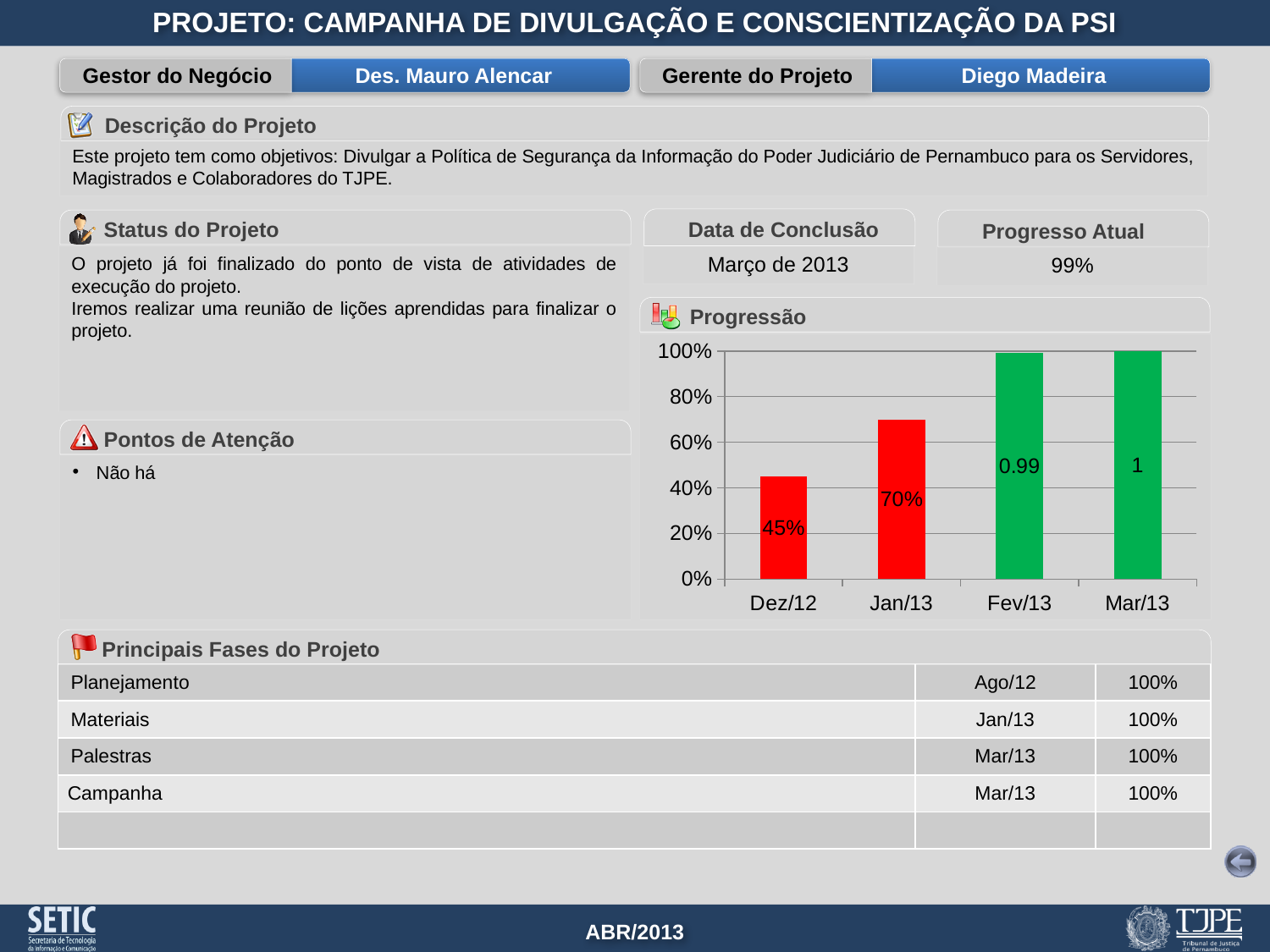
In the Progressão chart, is the value for Jan/13 greater or less than 60%? greater Do the values in the Progressão chart rise or fall from Dez/12 to Mar/13? rise In the Progressão chart, which is larger: the value for Dez/12 or the value for Jan/13? Jan/13 What kind of chart is the Progressão chart? bar chart What is the value for Jan/13 in the Progressão chart? 70% Which month has the lowest value in the Progressão chart? Dez/12 What data label is shown on the Mar/13 bar in the Progressão chart? 1 What colour are the Fev/13 and Mar/13 bars in the Progressão chart? green What data label is shown on the Fev/13 bar in the Progressão chart? 0.99 What is the difference between the Jan/13 and Dez/12 values in the Progressão chart? 25% What is the value for Dez/12 in the Progressão chart? 45% How many months are shown on the x axis of the Progressão chart? 4